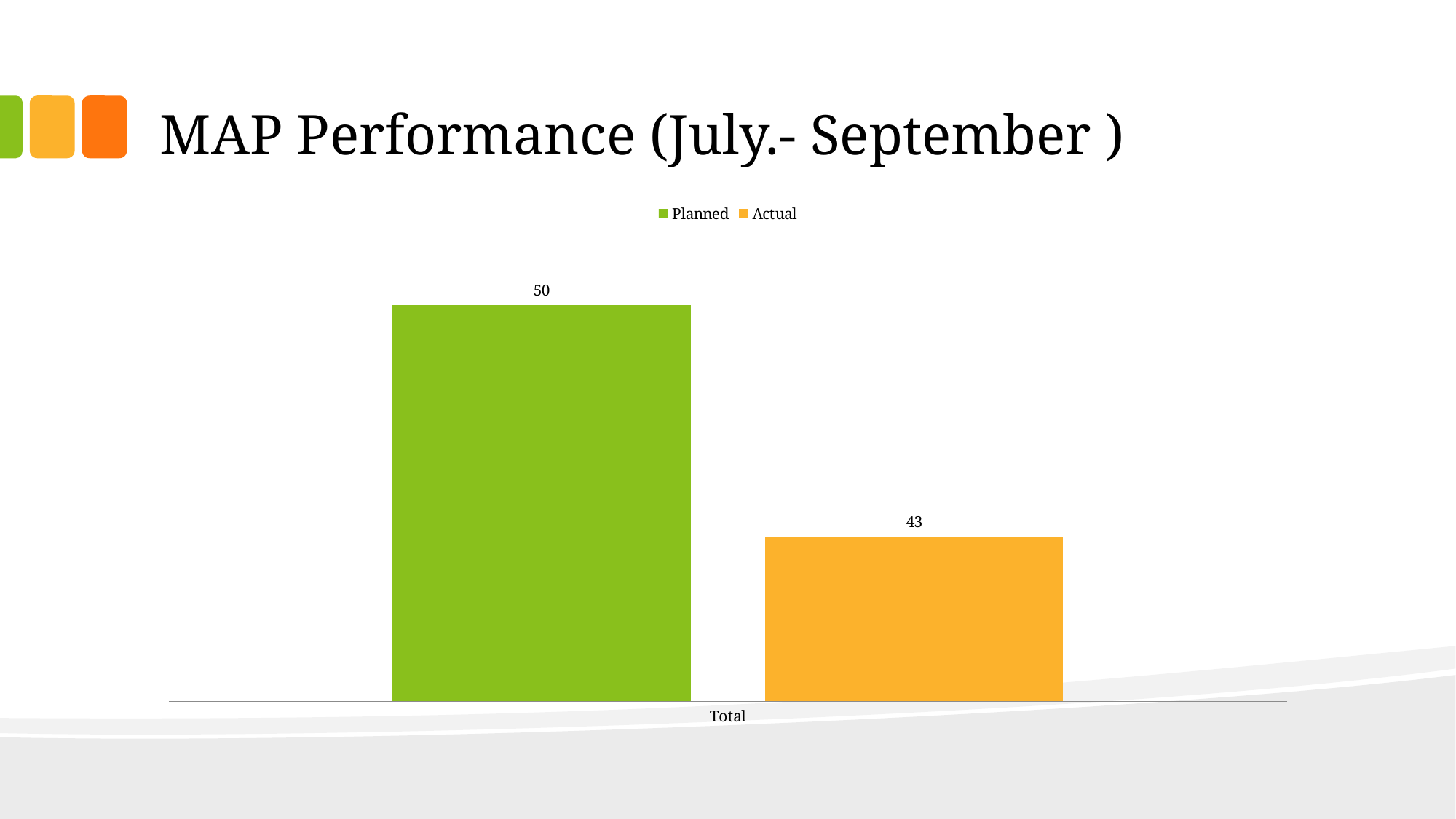
What is the label of the category on the x axis? Total Which series has the lowest value on the chart? Actual What is the Planned value for Total? 50 How many series does the legend list? 2 What is the Actual value for Total? 43 Which series has the higher value for Total, Planned or Actual? Planned What kind of chart is shown on the slide? Bar chart How many categories are shown on the x axis? 1 Which series is shown in green? Planned What is the difference between the Planned and Actual values for Total? 7